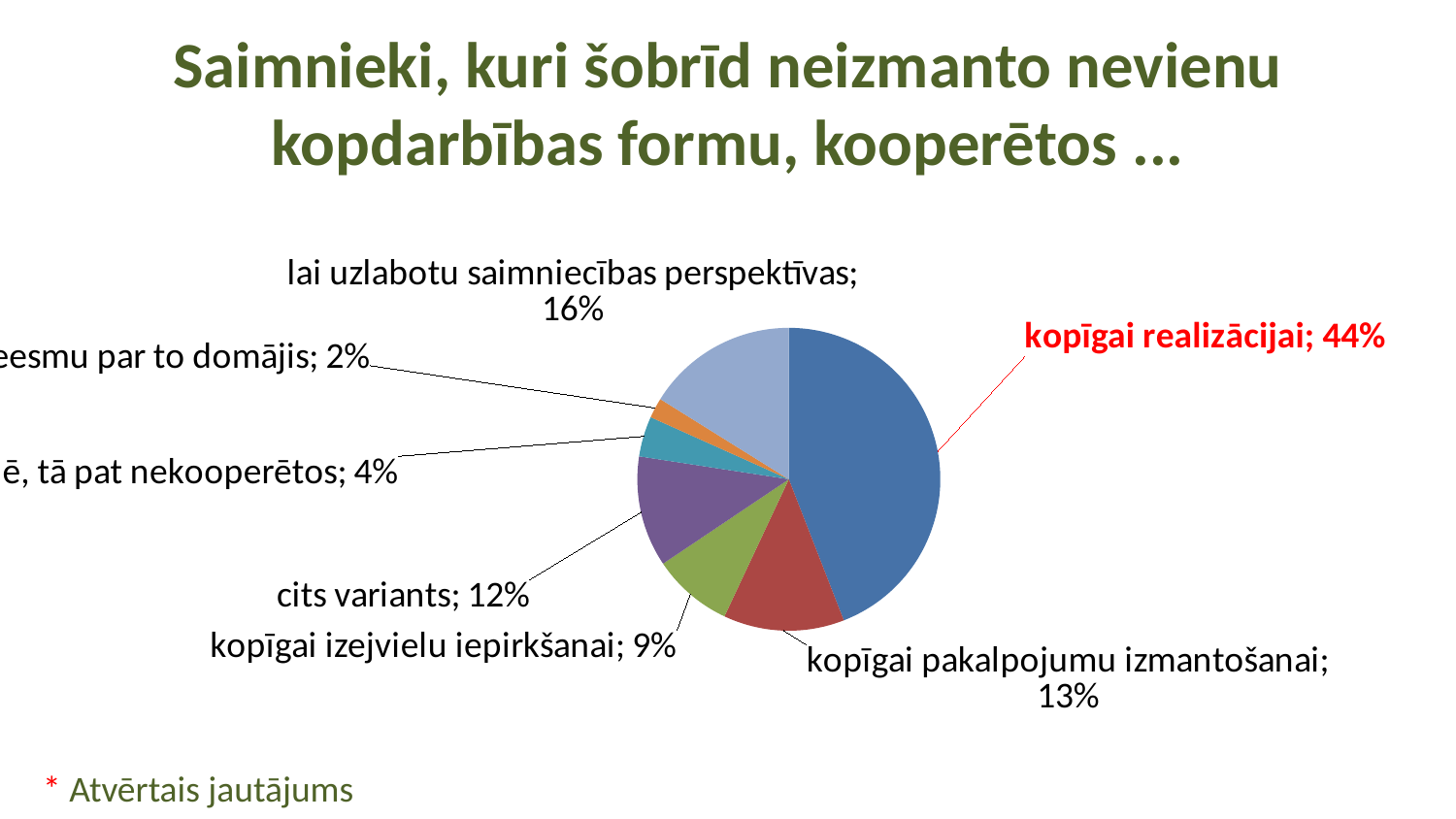
What is the smallest percentage shown on the pie chart? 2% How many slices does the pie chart have? 7 What kind of chart is shown on the slide? pie chart What share of the pie is labelled "kopīgai realizācijai"? 44% What percentage is shown for "kopīgai izejvielu iepirkšanai"? 9% What percentage is shown for "lai uzlabotu saimniecības perspektīvas"? 16% Which category has the largest share of the pie? kopīgai realizācijai What is the difference in percentage points between "kopīgai realizācijai" and "kopīgai pakalpojumu izmantošanai"? 31 percentage points What percentage is shown for "kopīgai pakalpojumu izmantošanai"? 13% What percentage is shown for "cits variants"? 12% Which data label on the pie chart is printed in red? kopīgai realizācijai; 44% Which is larger: the share for "cits variants" or the share for "kopīgai izejvielu iepirkšanai"? cits variants